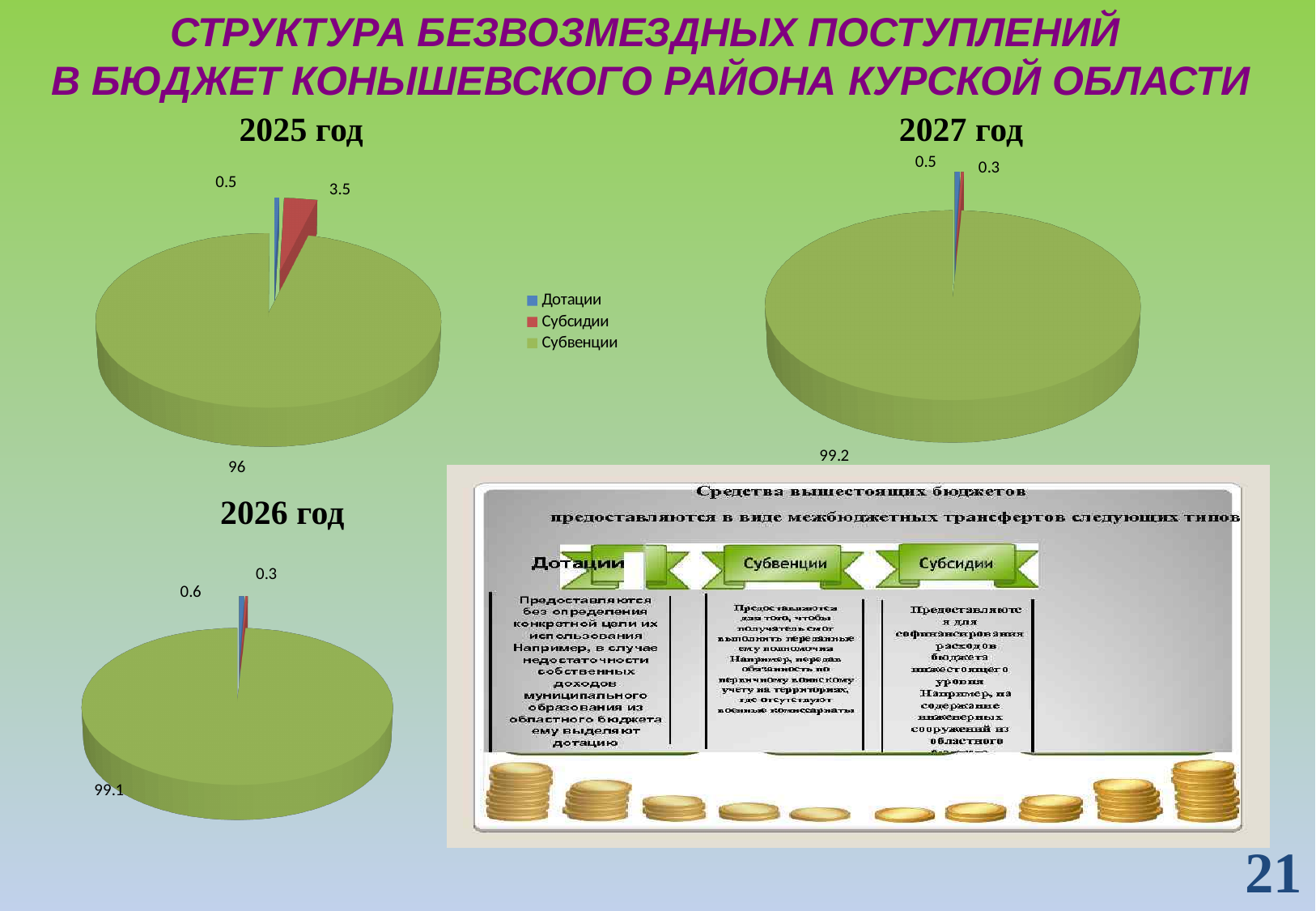
In the 2026 год chart, what is the value for Дотации? 0.6 In the 2026 год chart, which is larger, Дотации or Субсидии? Дотации In the 2025 год chart, what is the value for Субвенции? 96 In the 2025 год chart, what is the value for Субсидии? 3.5 Which colour represents Субсидии in the legend? Red In the 2025 год chart, what is the difference between the values for Субсидии and Дотации? 3 What type of chart is used for the 2026 год data? Pie chart How many pie charts are shown on the slide? 3 In the 2027 год chart, which category has the smallest share? Субсидии In the 2027 год chart, what is the value for Субвенции? 99.2 How many categories does the legend list for the pie charts? 3 In the 2025 год chart, which category has the largest share? Субвенции